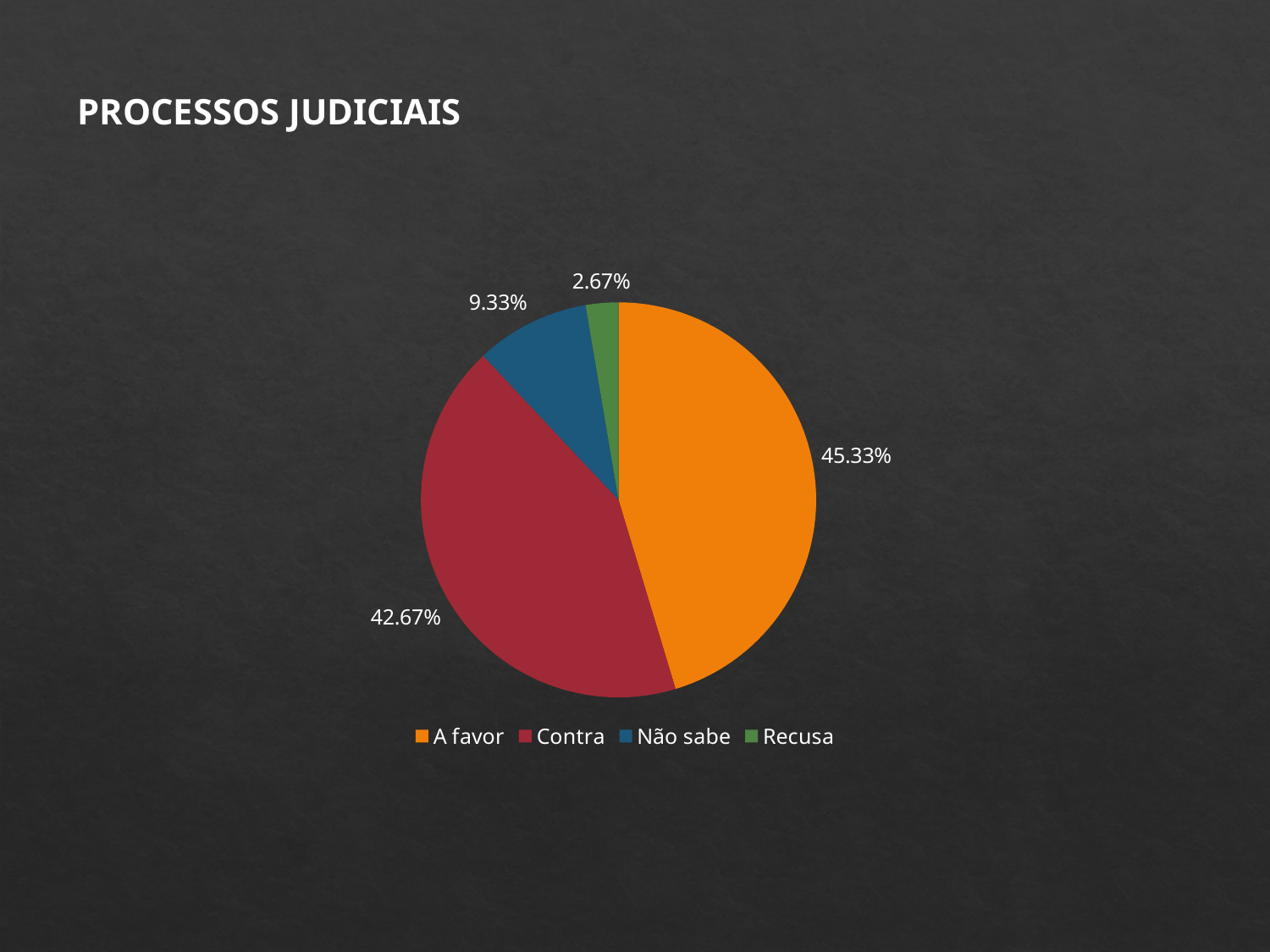
What is the value for A favor? 45.33% What is the title of the slide? PROCESSOS JUDICIAIS Which is larger, the value for Não sabe or the value for Recusa? Não sabe What is the difference between the values for Não sabe and Recusa? 6.66% What is the value for Não sabe? 9.33% What is the value for Recusa? 2.67% What type of chart is shown on the slide? pie chart What is the difference between the values for A favor and Contra? 2.66% Which category has the smallest share of the pie? Recusa What is the value for Contra? 42.67% How many categories does the pie chart have? 4 Which category has the largest share of the pie? A favor